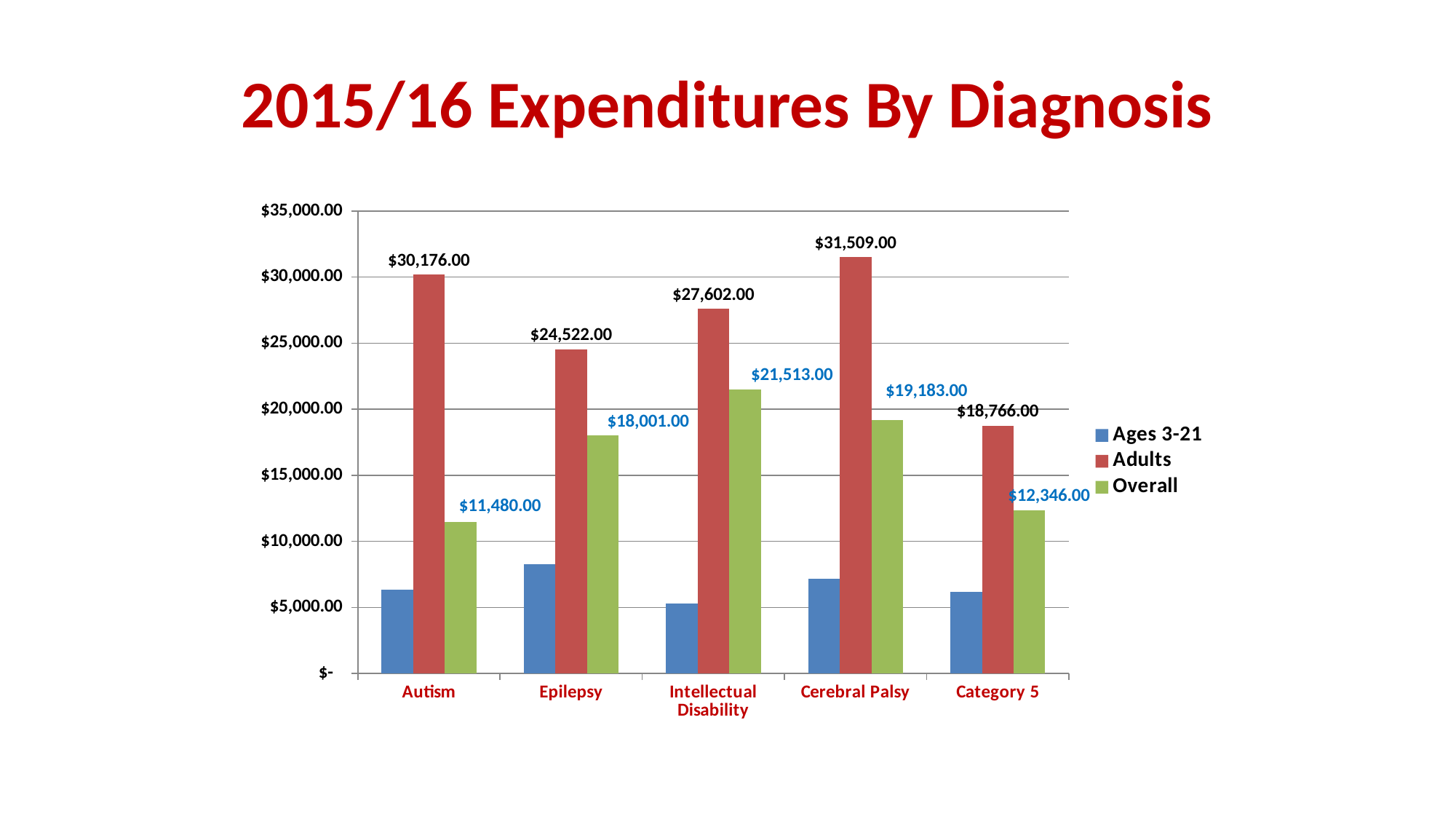
What kind of chart is shown on the slide? bar chart Which diagnosis has the lowest Overall expenditure? Autism How much higher is the Adults expenditure for Cerebral Palsy than for Autism? $1,333.00 What is the difference between the Overall expenditure for Intellectual Disability and for Category 5? $9,167.00 How many diagnosis categories are shown on the x axis? 5 Which diagnosis has the highest Adults expenditure? Cerebral Palsy What is the Overall expenditure for Intellectual Disability? $21,513.00 What is the title of the slide? 2015/16 Expenditures By Diagnosis Which is larger, the Overall expenditure for Epilepsy or for Cerebral Palsy? Cerebral Palsy Is the Ages 3-21 expenditure for Epilepsy greater or less than $10,000.00? less How many series does the legend list? 3 What is the Adults expenditure for Autism? $30,176.00